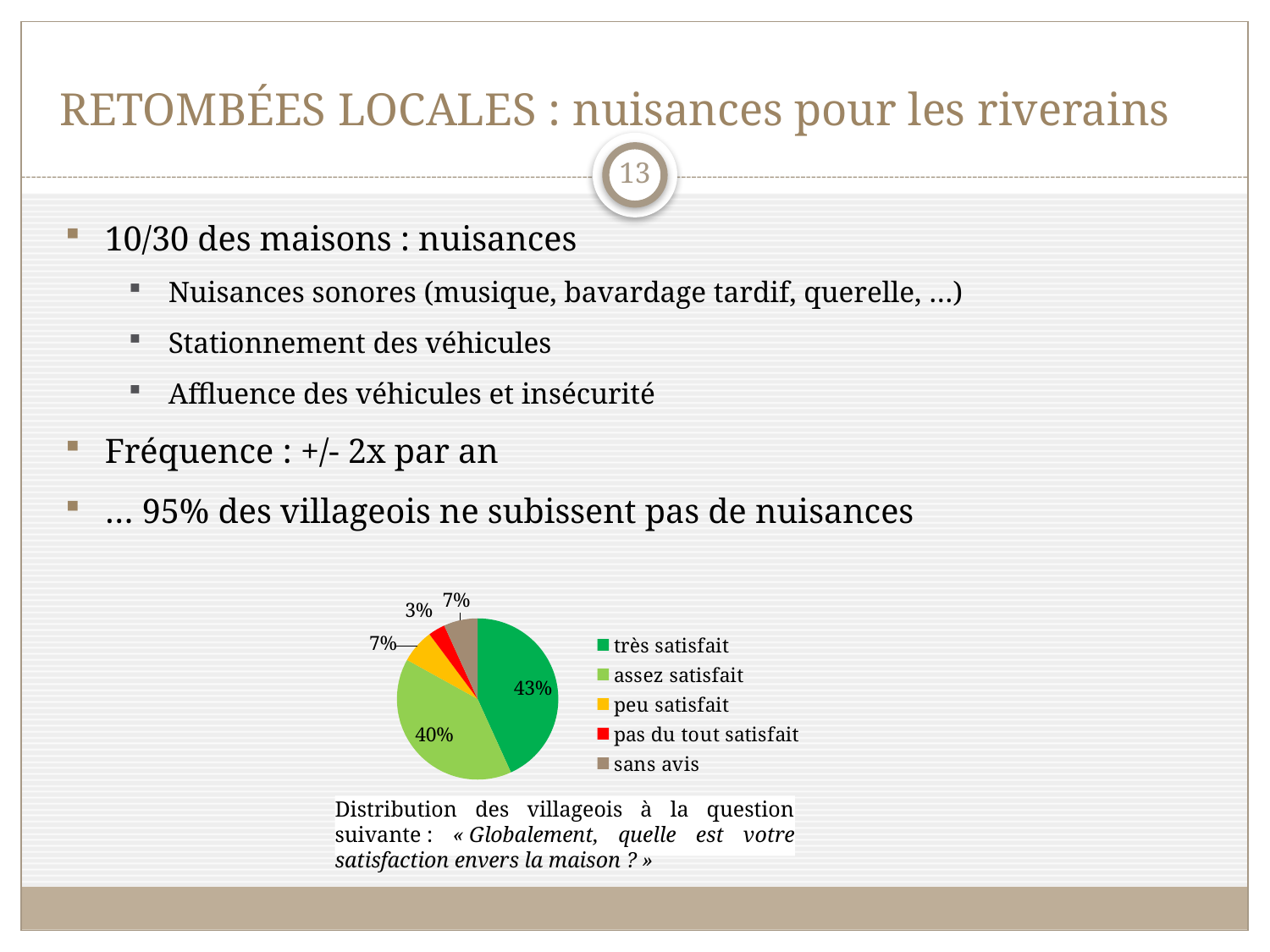
What share of villagers answered "sans avis"? 7% What share of villagers answered "très satisfait"? 43% What is the difference in percentage points between "très satisfait" and "assez satisfait"? 3 How many categories does the legend of the pie chart list? 5 What is the combined share of "très satisfait" and "assez satisfait"? 83% Which is larger, the share for "peu satisfait" or the share for "pas du tout satisfait"? peu satisfait What share of villagers answered "pas du tout satisfait"? 3% What kind of chart is shown on the slide? pie chart Which response category has the largest slice of the pie? très satisfait What share of villagers answered "assez satisfait"? 40% Which response category has the smallest slice of the pie? pas du tout satisfait What colour is the slice for "pas du tout satisfait"? red